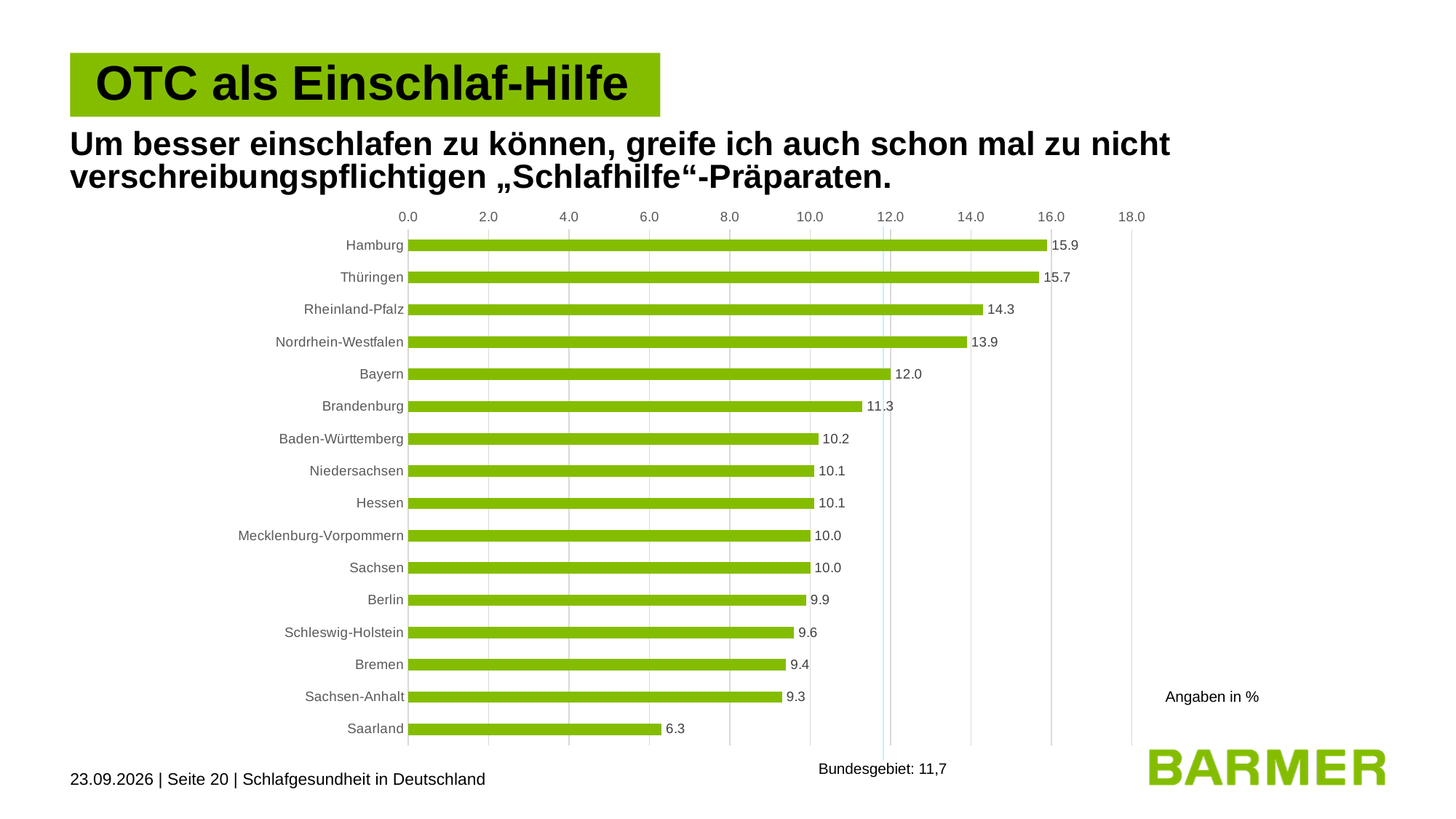
Which federal state has the lowest value? Saarland What kind of chart is shown on the slide? bar chart What value is given for Bundesgebiet below the chart? 11,7 Which federal state has the highest value? Hamburg What is the difference between the values for Rheinland-Pfalz and Nordrhein-Westfalen? 0.4 What is the value for Saarland? 6.3 What is the value for Hamburg? 15.9 How many federal states are shown in the chart? 16 What is the value for Bayern? 12.0 What is the difference between the values for Hamburg and Saarland? 9.6 Is the value for Thüringen greater or less than 14.0? greater Which has a larger value, Brandenburg or Bremen? Brandenburg